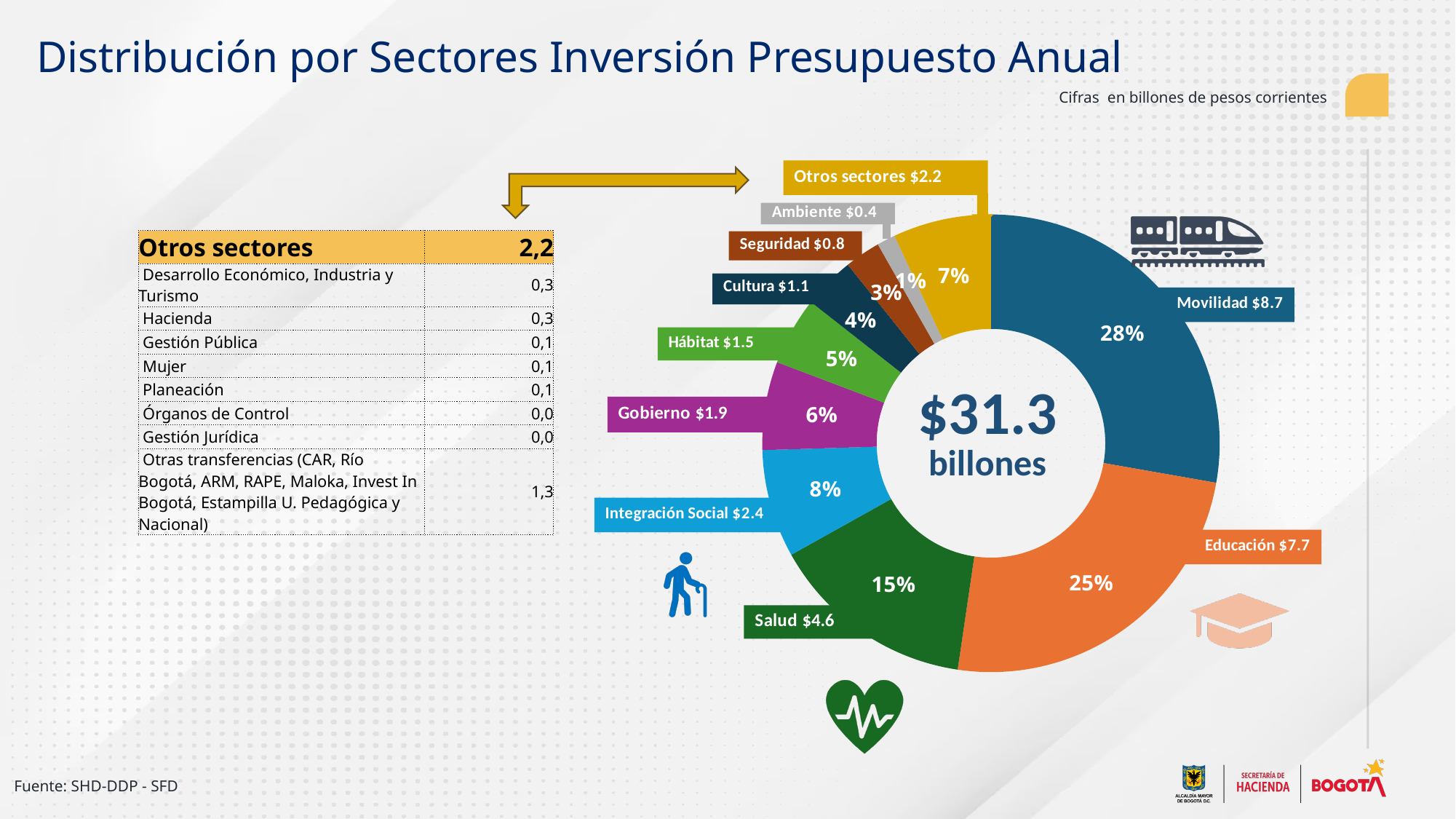
What is the value shown for Movilidad in the donut chart? $8.7 What total value is shown in the centre of the donut chart? $31.3 billones What is the title of the slide containing the donut chart? Distribución por Sectores Inversión Presupuesto Anual What percentage share does Otros sectores have in the donut chart? 7% What is the difference between the values for Movilidad and Educación in the donut chart? $1.0 How many sectors are shown in the donut chart? 10 What type of chart is shown on the slide? Donut (pie) chart Which sector has the smallest share in the donut chart? Ambiente What percentage share does Educación have in the donut chart? 25% What is the value shown for Seguridad in the donut chart? $0.8 Which is larger in the donut chart, Salud or Integración Social? Salud Which sector has the largest share in the donut chart? Movilidad